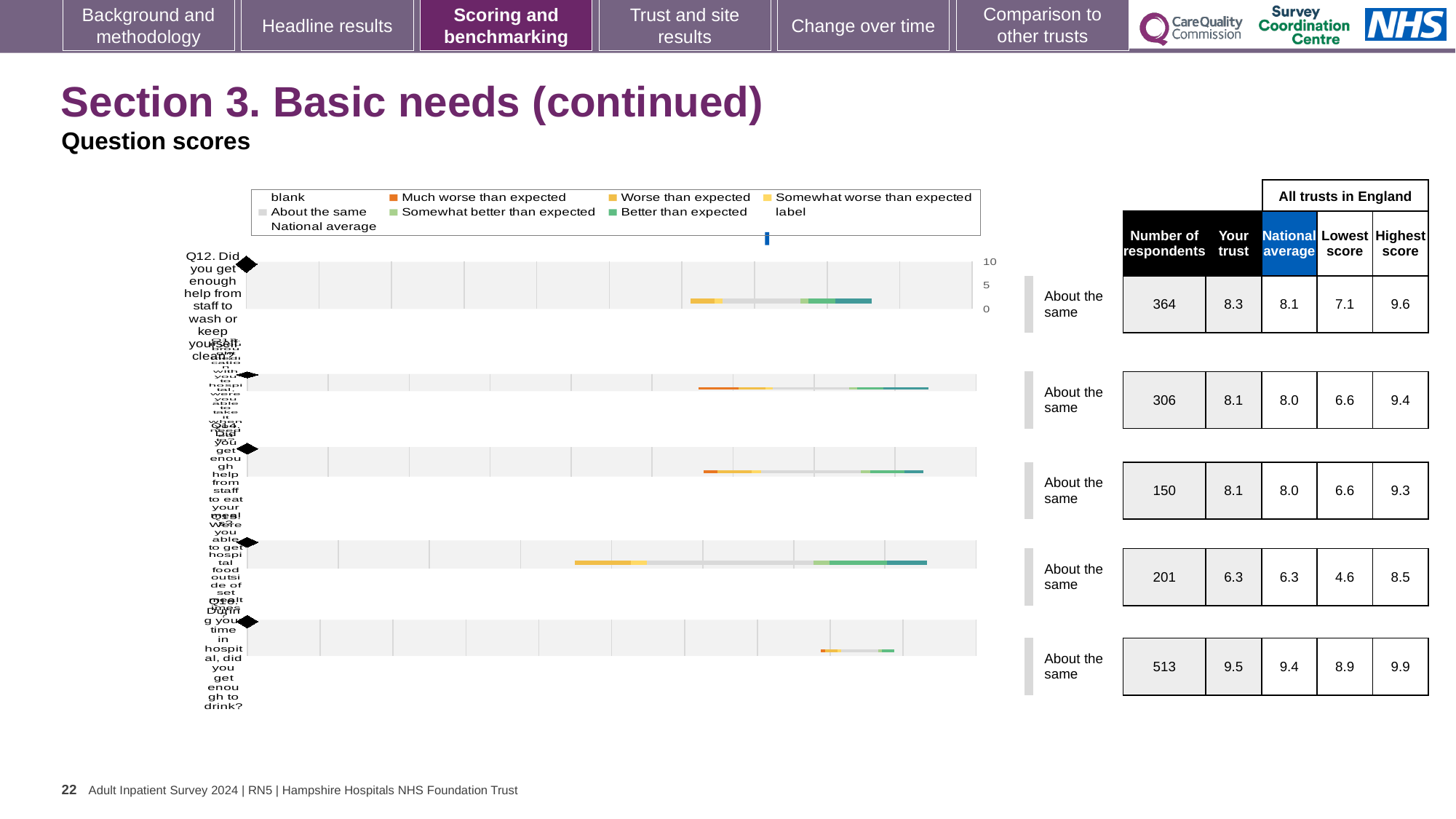
What is the difference between the 'Your trust' score and the national average for Q12? 0.2 What kind of chart is shown on the slide? Bar chart How many survey questions (bars) are plotted in the chart? 5 For Q12, is the 'Your trust' score or the national average score larger? Your trust (8.3) What benchmark category is shown for every question in the chart? About the same What is the highest score among all trusts in England for the fifth (bottom) question in the chart? 9.9 Which of the five questions has the lowest 'Your trust' score? The fourth question, 6.3 Which colour in the legend represents 'Much worse than expected'? Orange Which of the five questions has the highest 'Your trust' score? The fifth (bottom) question, 9.5 What is the national average score for Q12 (Did you get enough help from staff to wash or keep yourself clean?)? 8.1 How many respondents answered Q12 (Did you get enough help from staff to wash or keep yourself clean?)? 364 What is the 'Your trust' score for Q12 (Did you get enough help from staff to wash or keep yourself clean?)? 8.3